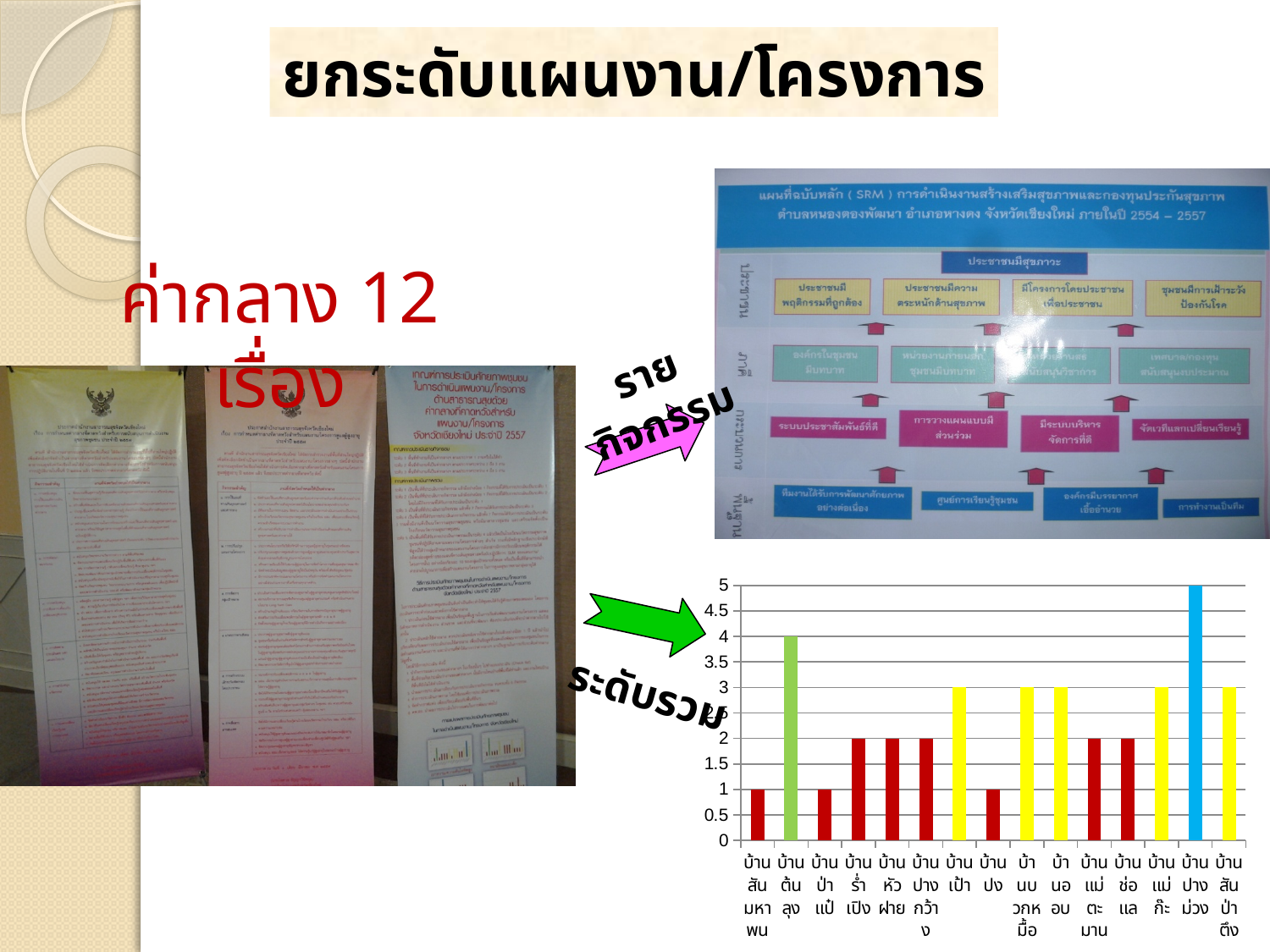
What type of chart is shown at the bottom right of the slide? bar chart In the bar chart, what is the value for บ้านร่ำเปิง? 2 In the bar chart, what is the value for บ้านเป้า? 3 In the bar chart, what is the value for บ้านต้นลุง? 4 In the bar chart, what colour is the tallest bar? blue How many categories are shown on the x axis of the bar chart? 15 In the bar chart, what is the value for บ้านสันมหาพน? 1 In the bar chart, what is the value for บ้านปางม่วง? 5 In the bar chart, what is the difference between the values for บ้านปางม่วง and บ้านต้นลุง? 1 In the bar chart, is the value for บ้านปางม่วง greater or less than 4? greater In the bar chart, which category has the highest value? บ้านปางม่วง In the bar chart, which is larger, the value for บ้านต้นลุง or the value for บ้านเป้า? บ้านต้นลุง